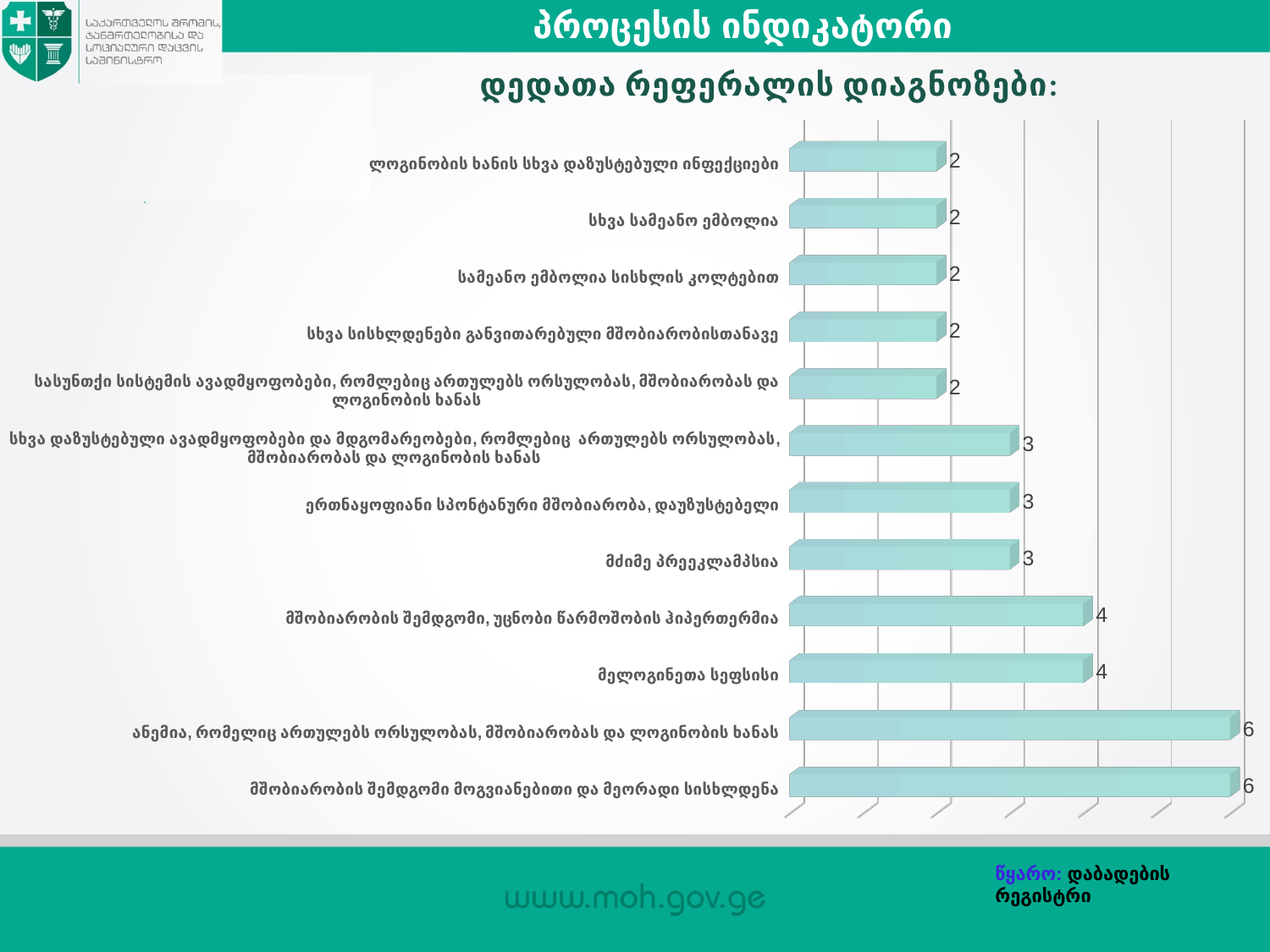
What is the value for მელოგინეთა სეფსისი? 4 How many categories have a value of 2? 5 What is the value for სხვა სამეანო ემბოლია? 2 What is the highest value shown in the chart? 6 What type of chart is shown on the slide? bar chart What is the value for მძიმე პრეეკლამფსია? 3 What is the difference between the value for ანემია, რომელიც ართულებს ორსულობას, მშობიარობას და ლოგინობის ხანას and the value for მძიმე პრეეკლამფსია? 3 What is the title of the chart? დედათა რეფერალის დიაგნოზები: What is the value for მშობიარობის შემდგომი მოგვიანებითი და მეორადი სისხლდენა? 6 How many categories are plotted in the chart? 12 Which has a larger value: მელოგინეთა სეფსისი or ერთნაყოფიანი სპონტანური მშობიარობა, დაუზუსტებელი? მელოგინეთა სეფსისი What is the lowest value shown in the chart? 2